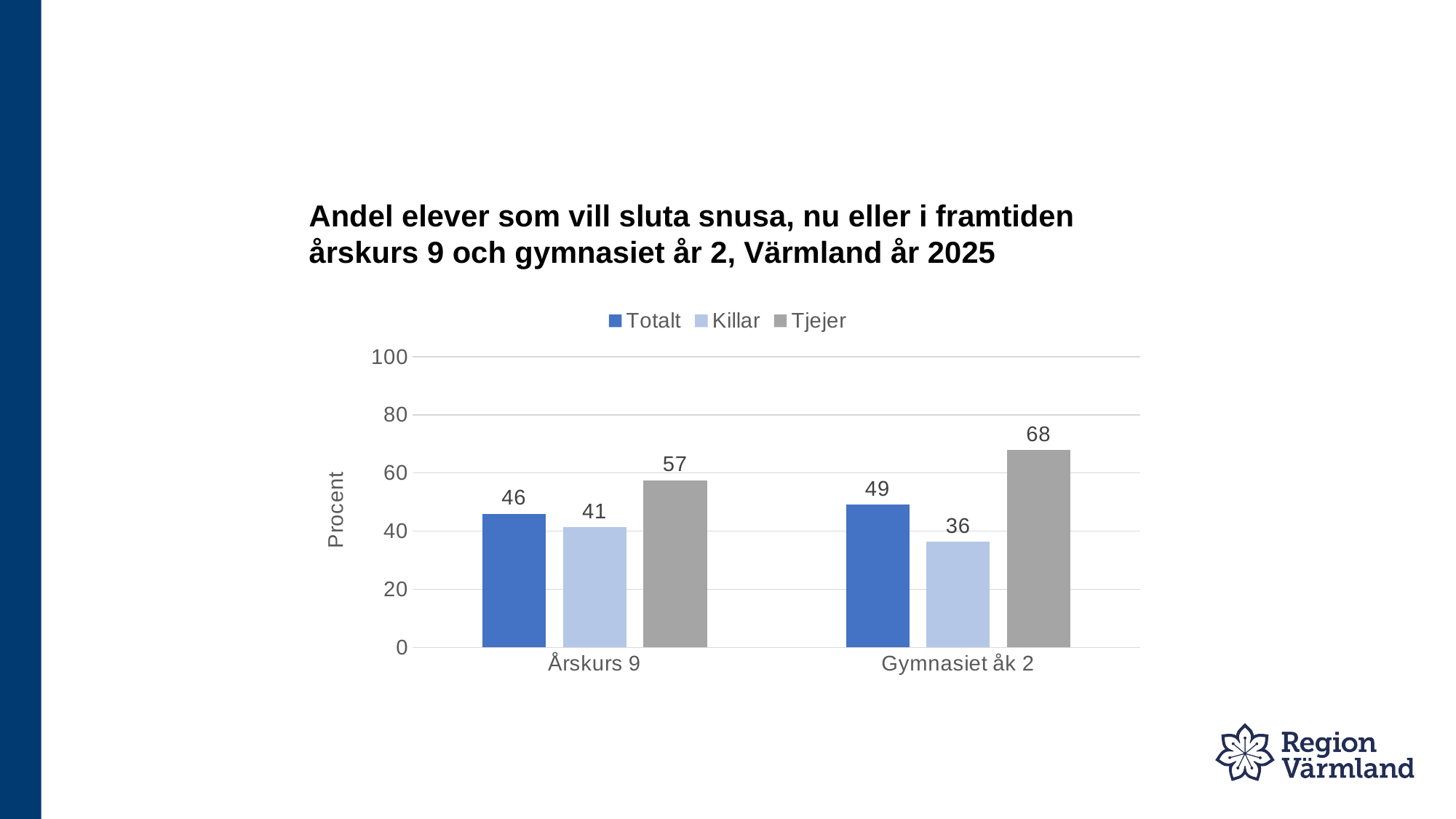
What kind of chart is shown on the slide? Bar chart Which series has the highest value in Gymnasiet åk 2? Tjejer What is the label of the y axis? Procent How many series does the legend list? 3 What is the value for Killar in Gymnasiet åk 2? 36 What is the difference between Totalt in Gymnasiet åk 2 and Totalt in Årskurs 9? 3 Which is larger: Killar in Årskurs 9 or Killar in Gymnasiet åk 2? Killar in Årskurs 9 How many categories are shown on the x axis? 2 What is the value for Totalt in Gymnasiet åk 2? 49 Which series has the lowest value in Årskurs 9? Killar What is the value for Tjejer in Årskurs 9? 57 What is the difference between Tjejer and Killar in Gymnasiet åk 2? 32